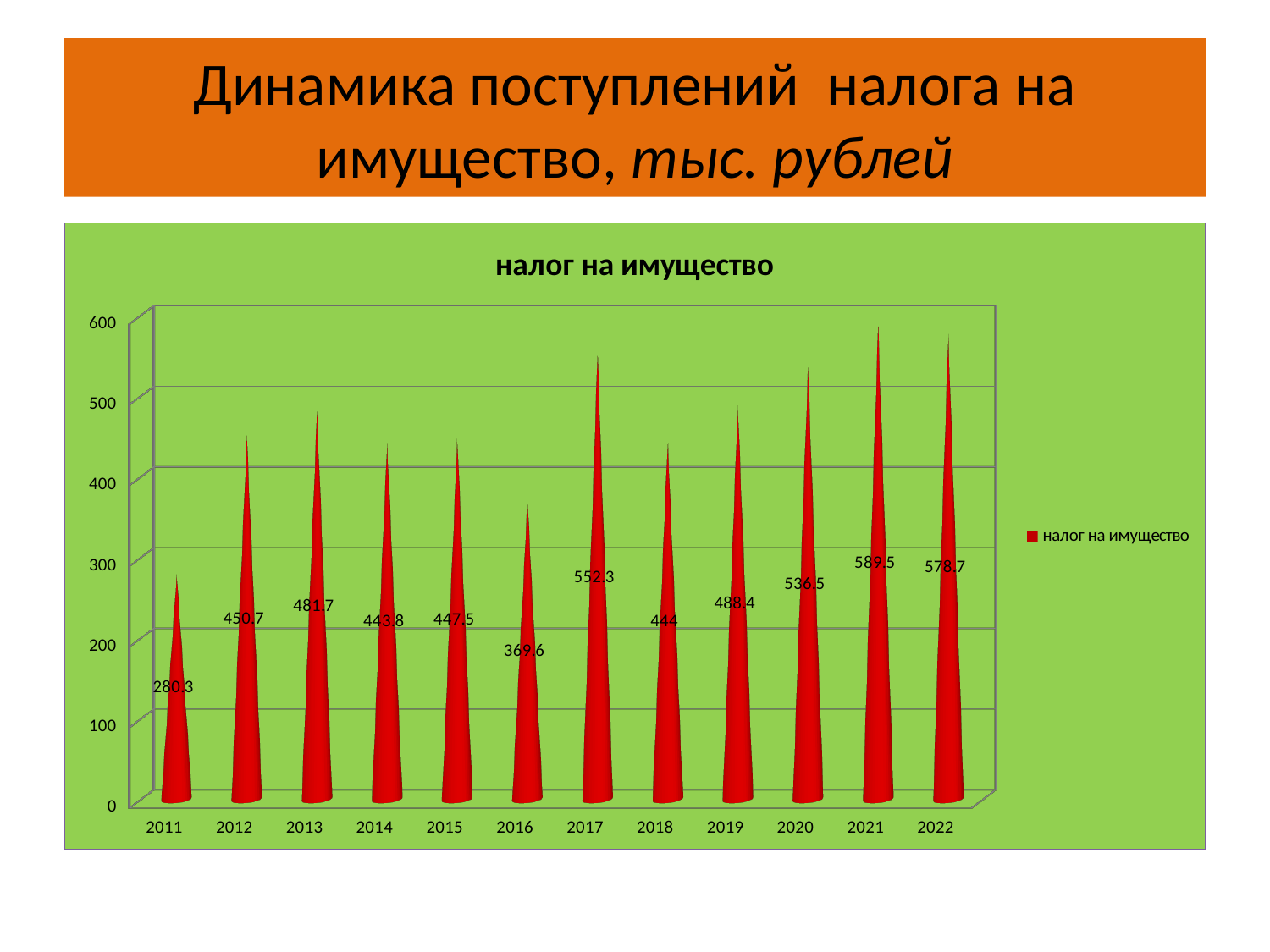
Which year has the lowest value in the chart? 2011 What kind of chart is shown on the slide? bar chart How many series does the legend list? 1 Which year has the highest value in the chart? 2021 What is the difference between the values for 2021 and 2022? 10.8 Is the value for 2016 greater or less than 400? less How many years are shown on the x axis of the chart? 12 What is the value for 2017 in the chart? 552.3 Which is larger, the value for 2013 or the value for 2019? 2019 What is the value for 2022 in the chart? 578.7 What is the difference between the values for 2017 and 2016? 182.7 What is the value for 2011 in the chart? 280.3